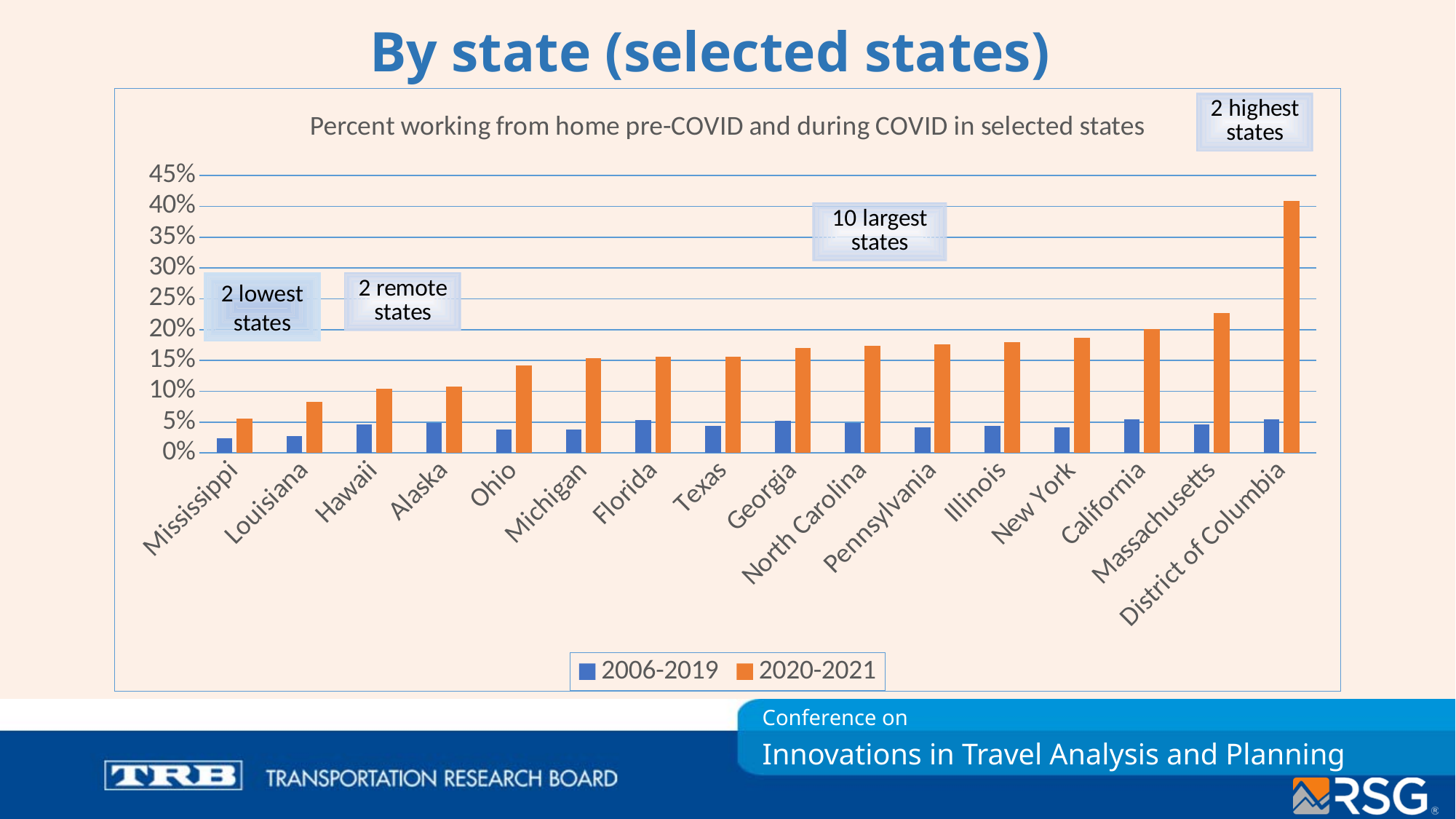
Which state has the highest 2020-2021 value? District of Columbia Do the 2020-2021 values rise or fall moving from left to right along the x axis? rise Which state has the lowest 2020-2021 value? Mississippi Is the 2020-2021 value for District of Columbia greater or less than 35%? greater How many states (categories) are shown on the x axis of the chart? 16 Which is larger, the 2020-2021 value for Massachusetts or for California? Massachusetts What is the title of the chart? Percent working from home pre-COVID and during COVID in selected states What kind of chart is shown on the slide? bar chart Is the 2006-2019 value for Mississippi greater or less than 5%? less Is the 2020-2021 value for Massachusetts greater or less than 20%? greater How many series does the chart's legend list? 2